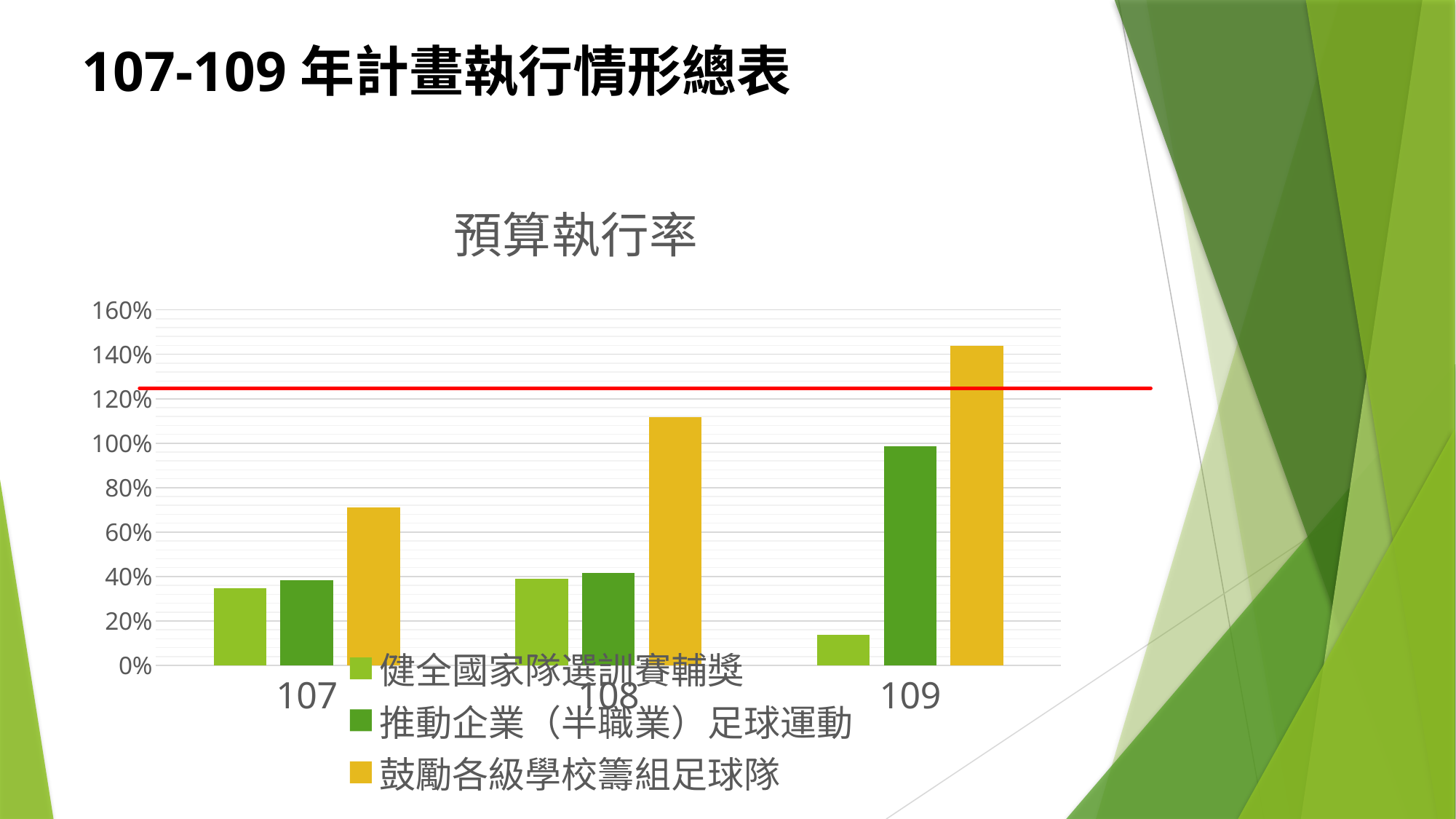
What colour are the bars for 鼓勵各級學校籌組足球隊? yellow Do the values for 鼓勵各級學校籌組足球隊 rise or fall from 107 to 109? rise Which year has the highest value for 鼓勵各級學校籌組足球隊? 109 Is the value for 健全國家隊選訓賽輔獎 in 109 greater or less than 20%? less Which year has the lowest value for 健全國家隊選訓賽輔獎? 109 Is the value for 鼓勵各級學校籌組足球隊 in 108 greater or less than 100%? greater Is the value for 鼓勵各級學校籌組足球隊 in 109 greater or less than 140%? greater What kind of chart is shown on the slide? bar chart What is the title of the chart? 預算執行率 Which is larger in 109: 推動企業（半職業）足球運動 or 健全國家隊選訓賽輔獎? 推動企業（半職業）足球運動 How many year categories are shown on the x axis? 3 How many series does the legend list? 3